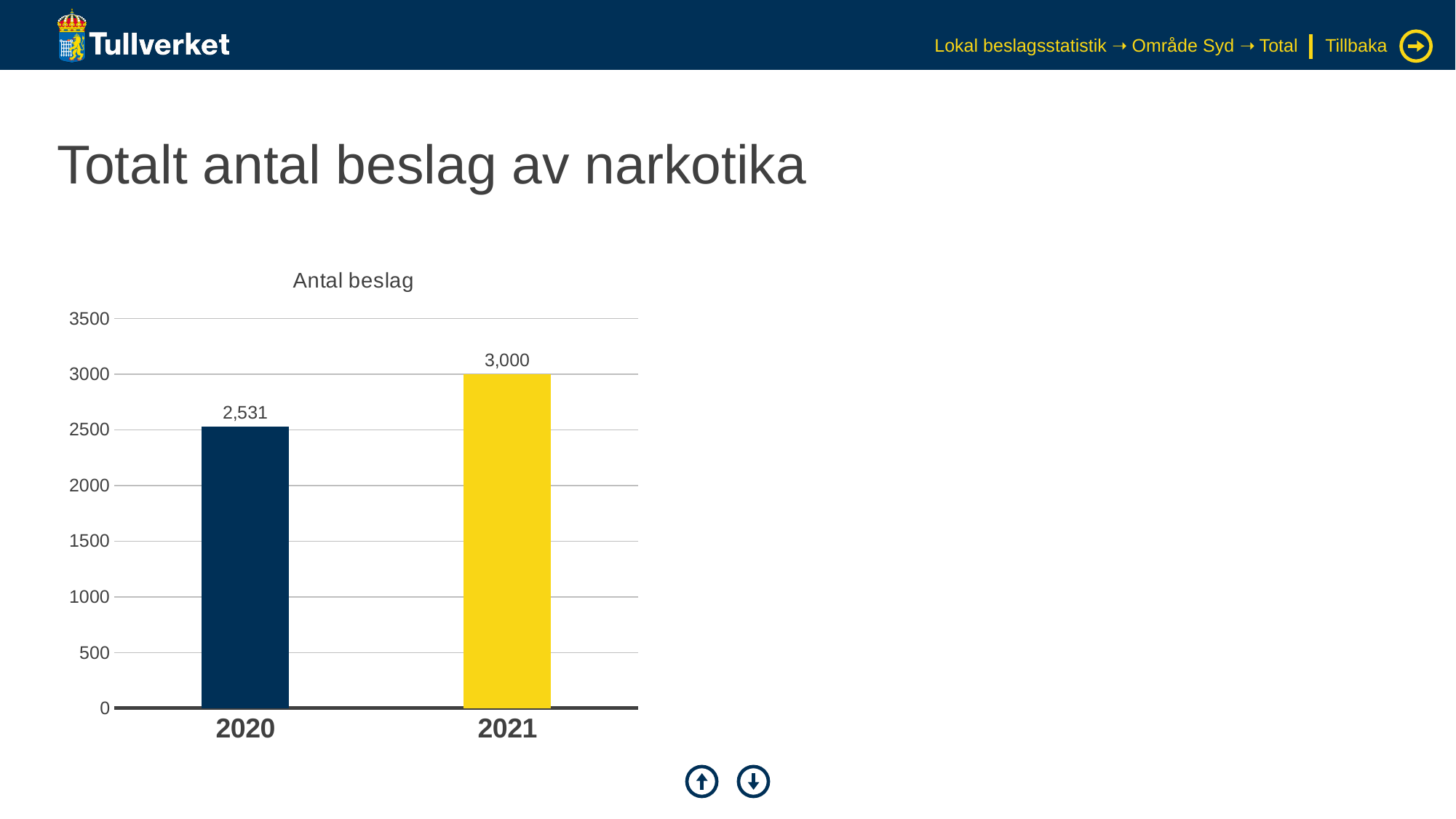
Is the value for 2020 greater or less than 2000? greater Do the values rise or fall from 2020 to 2021? rise What is the title of the chart? Antal beslag Which year has the highest number of seizures? 2021 Is the value for 2021 greater or less than 3500? less How many years are shown on the x axis? 2 Which is larger, the value for 2020 or the value for 2021? 2021 What is the difference between the values for 2021 and 2020? 469 What kind of chart is shown on the slide? bar chart What is the value for 2021? 3,000 Which year has the lowest number of seizures? 2020 What is the value for 2020? 2,531